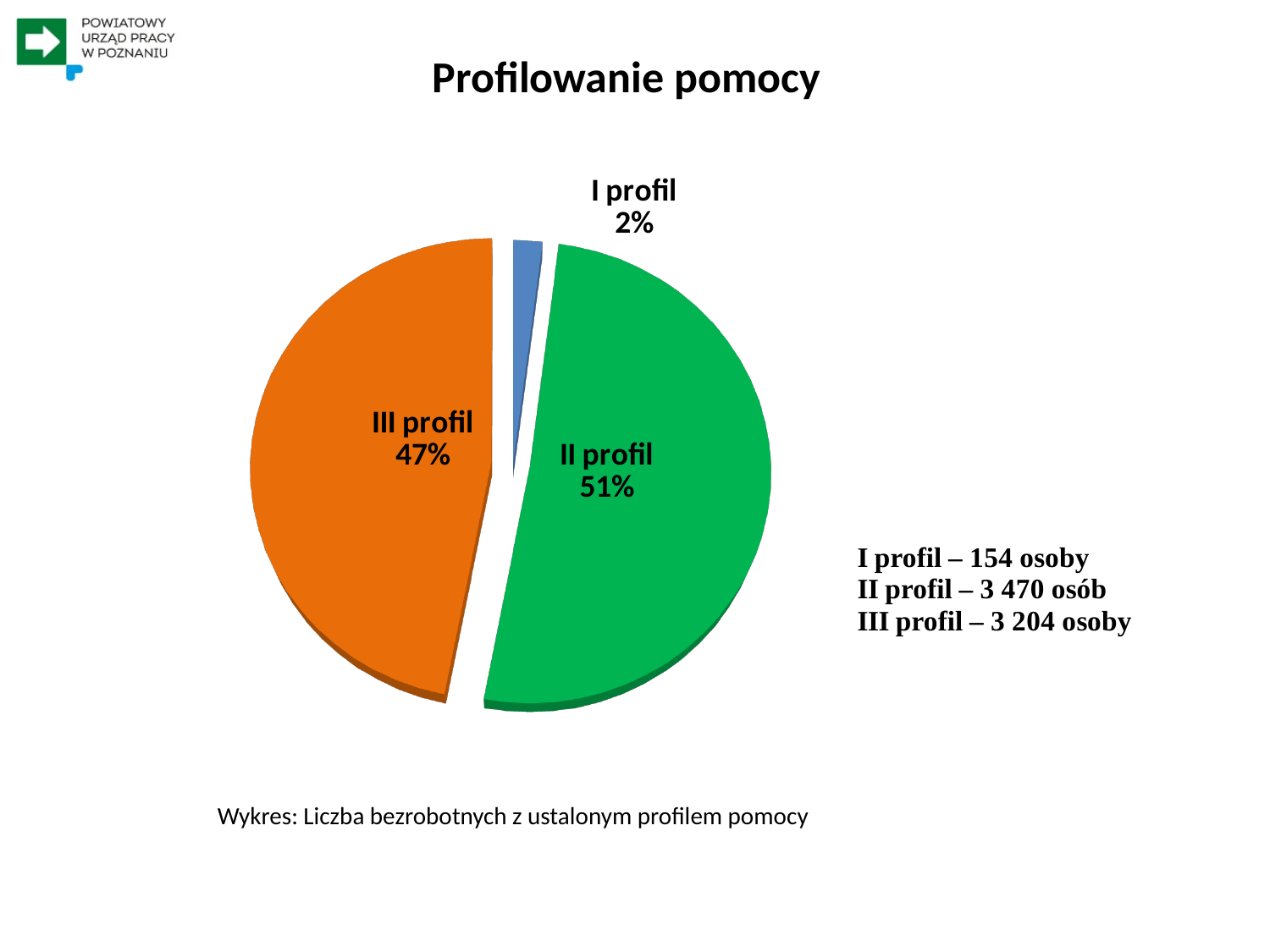
How many slices does the pie chart have? 3 Which profile has the smallest slice of the pie? I profil Which profile has the largest slice of the pie? II profil Which slice is larger, II profil or III profil? II profil What share of the pie does III profil represent? 47% What is the difference in percentage points between the III profil and I profil slices? 45 What share of the pie does I profil represent? 2% What is the difference in percentage points between the II profil and III profil slices? 4 What share of the pie does II profil represent? 51% What kind of chart is shown on the slide? pie chart What is the title of the slide above the chart? Profilowanie pomocy What colour is the III profil slice? orange